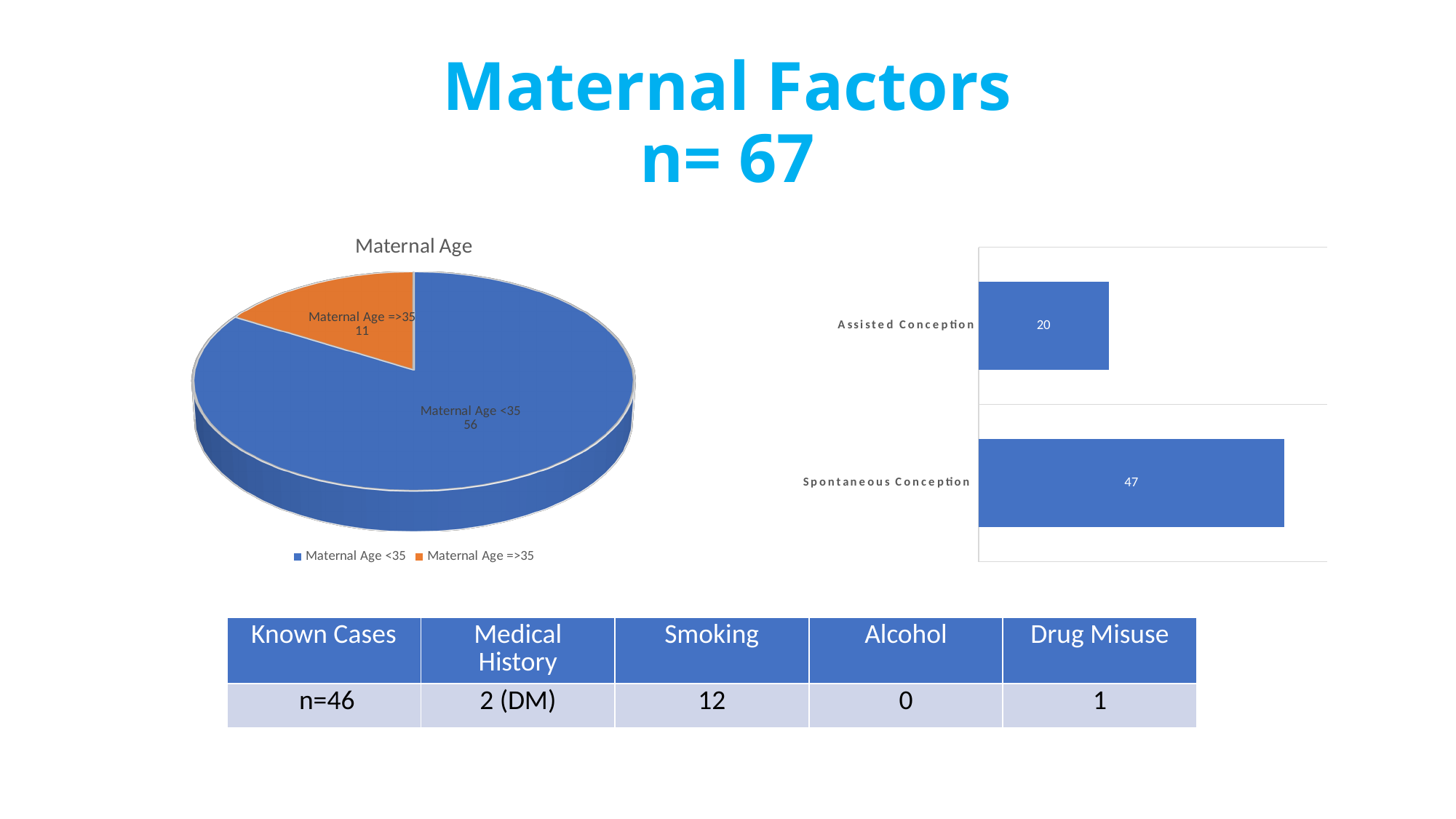
In the Maternal Age pie chart, how many slices are there? 2 In the Maternal Age pie chart, which slice is the largest? Maternal Age <35 In the bar chart on the right, what is the value for Assisted Conception? 20 In the Maternal Age pie chart, what is the value for Maternal Age =>35? 11 In the Maternal Age pie chart, what is the difference between the Maternal Age <35 and Maternal Age =>35 values? 45 What kind of chart is the Maternal Age chart on the left? Pie chart In the Maternal Age pie chart, what is the value for Maternal Age <35? 56 In the Maternal Age pie chart, what colour is the Maternal Age =>35 slice? Orange In the bar chart on the right, which category has the higher value, Assisted Conception or Spontaneous Conception? Spontaneous Conception In the bar chart on the right, what is the difference between Spontaneous Conception and Assisted Conception? 27 In the bar chart on the right, what is the value for Spontaneous Conception? 47 What kind of chart is the chart on the right of the slide? Bar chart